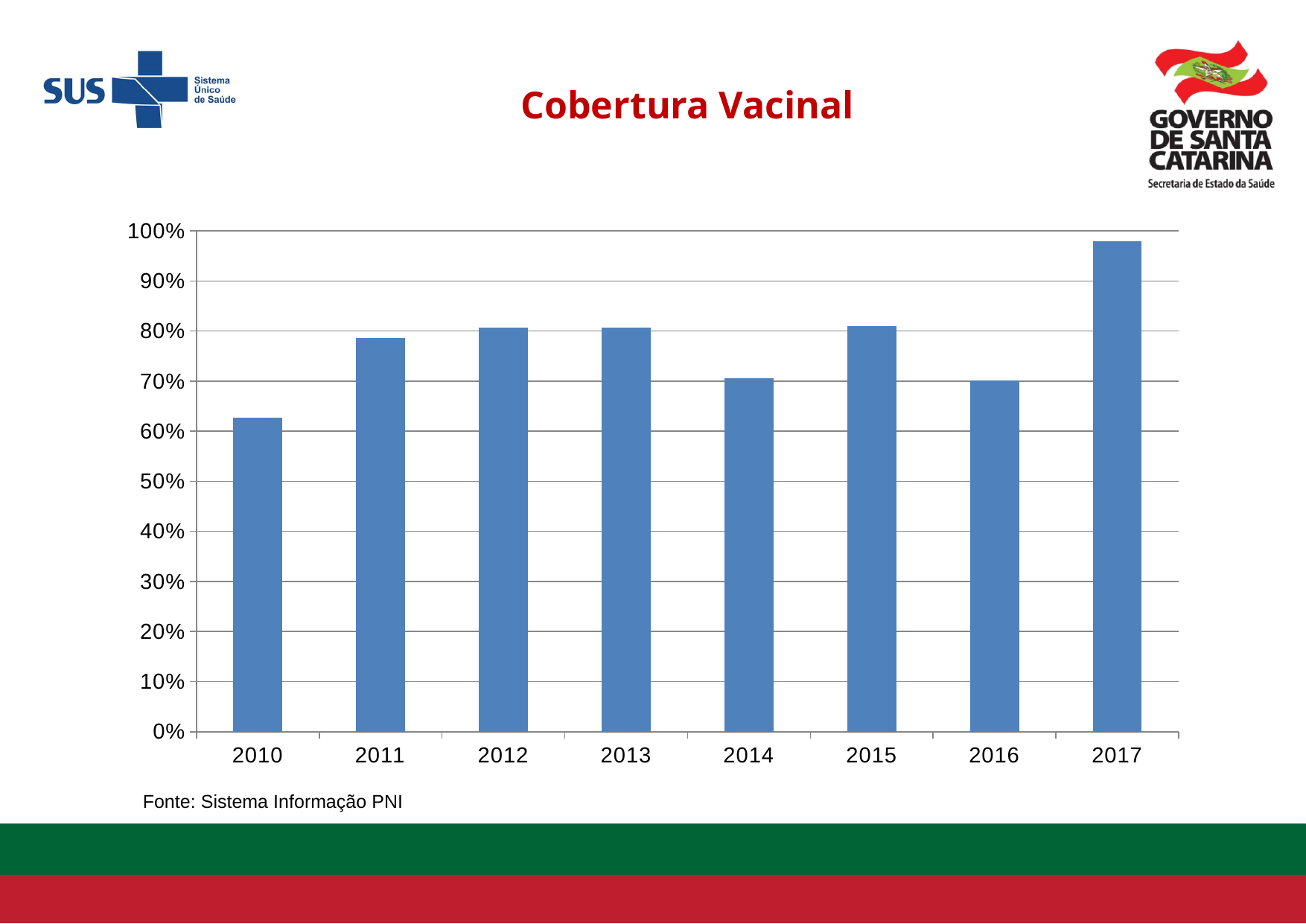
Is the value for 2011 greater or less than 80%? less Is the value for 2017 greater or less than 90%? greater Which is larger, the value for 2011 or the value for 2014? 2011 What source is cited below the chart? Sistema Informação PNI What kind of chart is shown on the slide? bar chart What is the title of the chart on the slide? Cobertura Vacinal Is the value for 2010 greater or less than 60%? greater Which year has the lowest value in the chart? 2010 Do the values rise or fall from 2010 to 2012? rise Which year has the highest value in the chart? 2017 How many years are shown on the x axis of the chart? 8